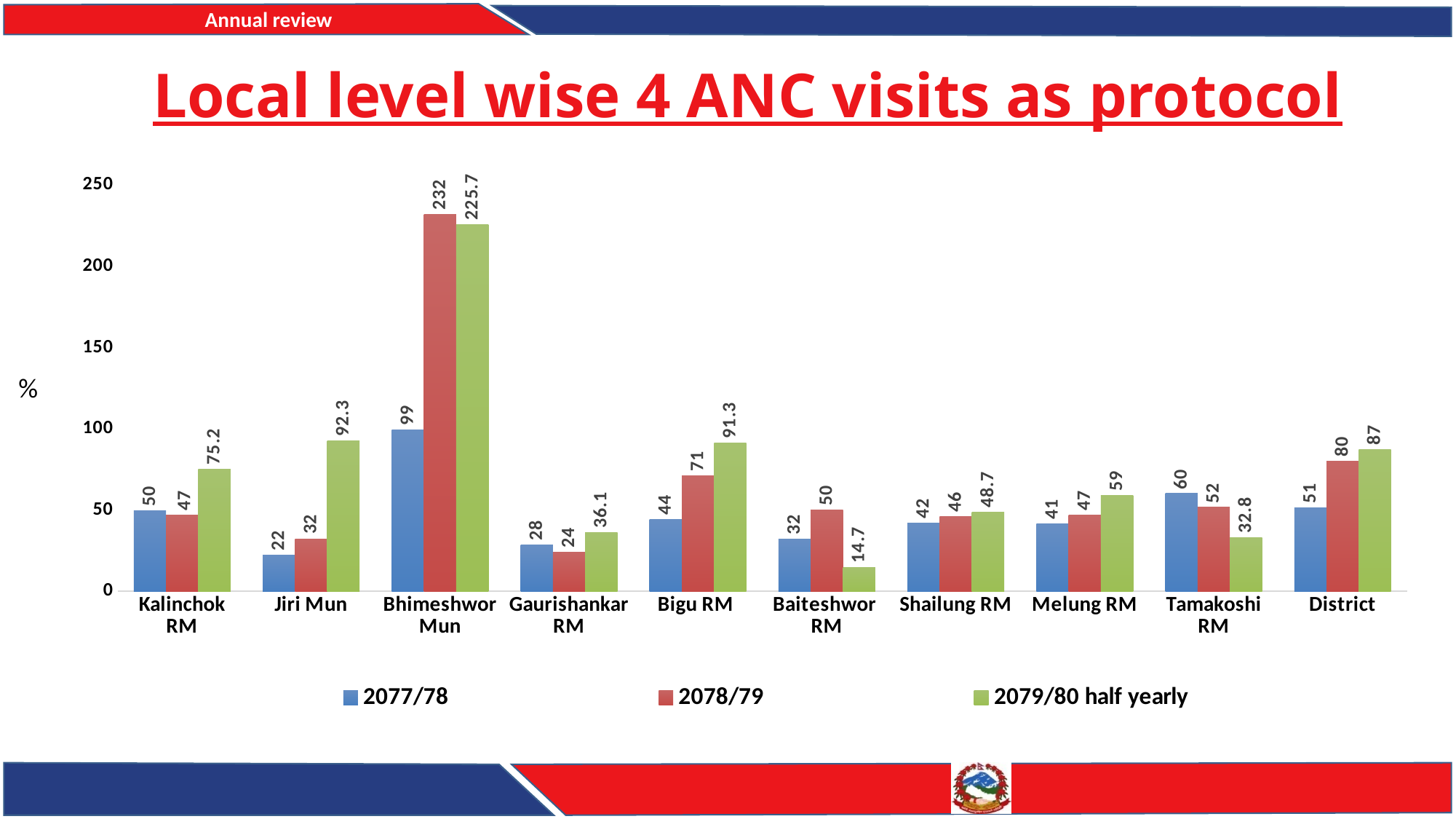
Which is larger for Melung RM: the 2077/78 value or the 2079/80 half yearly value? 2079/80 half yearly How many local level categories are shown on the x axis? 10 What is the title of the chart? Local level wise 4 ANC visits as protocol How many series does the legend list? 3 Which local level has the highest 2079/80 half yearly value? Bhimeshwor Mun What is the difference between the 2078/79 and 2077/78 values for Bigu RM? 27 What is the 2077/78 value for Tamakoshi RM? 60 Is the 2079/80 half yearly value for Bhimeshwor Mun greater or less than 200? greater What is the 2078/79 value for Bhimeshwor Mun? 232 Which local level has the lowest 2079/80 half yearly value? Baiteshwor RM What kind of chart is shown on the slide? Bar chart What is the 2079/80 half yearly value for Jiri Mun? 92.3